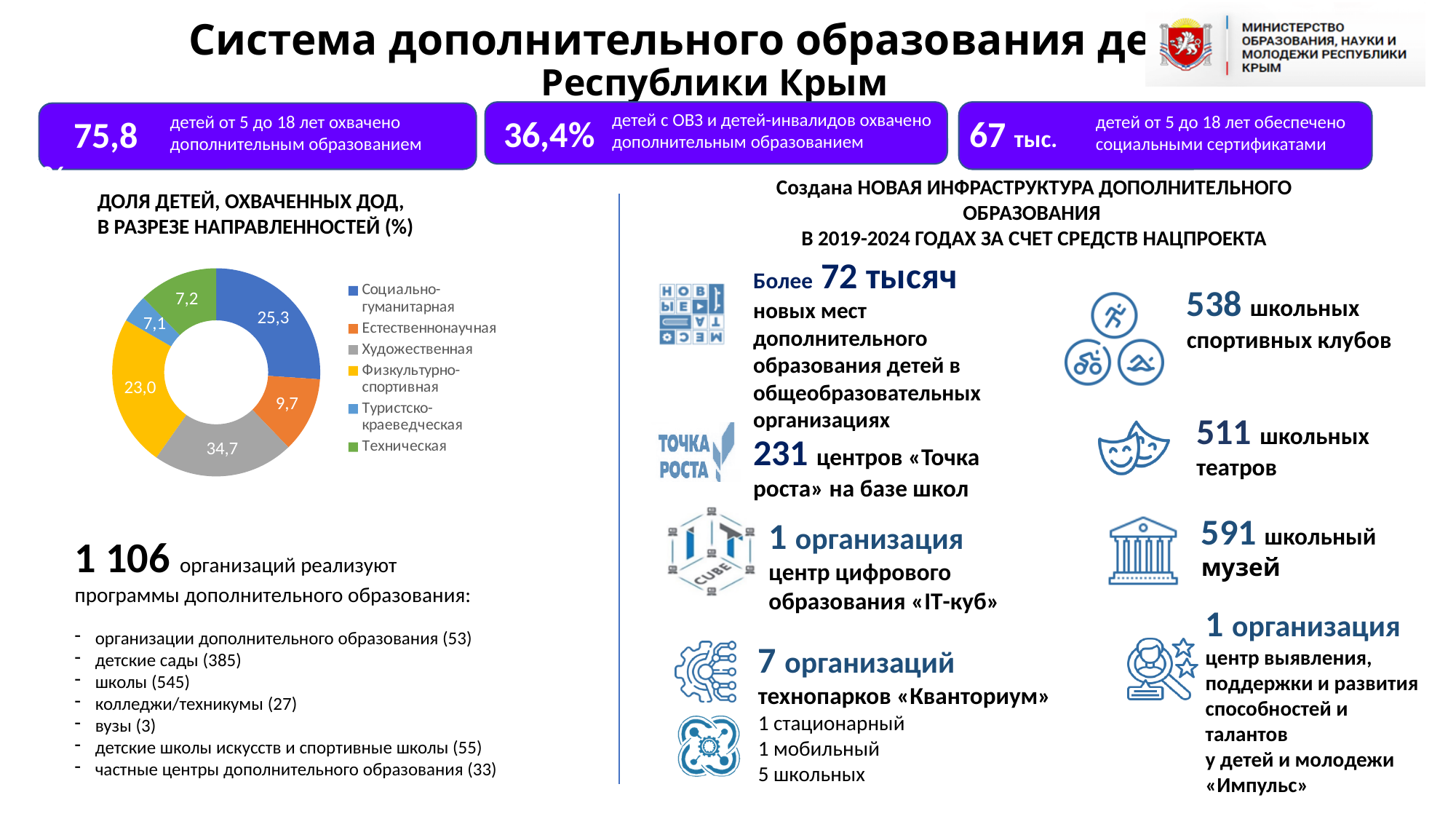
What kind of chart is shown under the title «ДОЛЯ ДЕТЕЙ, ОХВАЧЕННЫХ ДОД, В РАЗРЕЗЕ НАПРАВЛЕННОСТЕЙ (%)»? Doughnut (pie) chart What is the value for «Туристско-краеведческая» in the doughnut chart? 7,1 What is the difference between the values for «Социально-гуманитарная» and «Физкультурно-спортивная» in the doughnut chart? 2,3 Which colour represents «Физкультурно-спортивная» in the doughnut chart? Yellow What is the value for «Естественнонаучная» in the doughnut chart? 9,7 How many categories does the doughnut chart show? 6 Which category has the largest share in the doughnut chart? Художественная What is the difference between the values for «Художественная» and «Социально-гуманитарная» in the doughnut chart? 9,4 What is the value for «Социально-гуманитарная» in the doughnut chart? 25,3 What is the value for «Физкультурно-спортивная» in the doughnut chart? 23,0 What is the value for «Художественная» in the doughnut chart? 34,7 Which is larger in the doughnut chart: «Социально-гуманитарная» or «Естественнонаучная»? Социально-гуманитарная